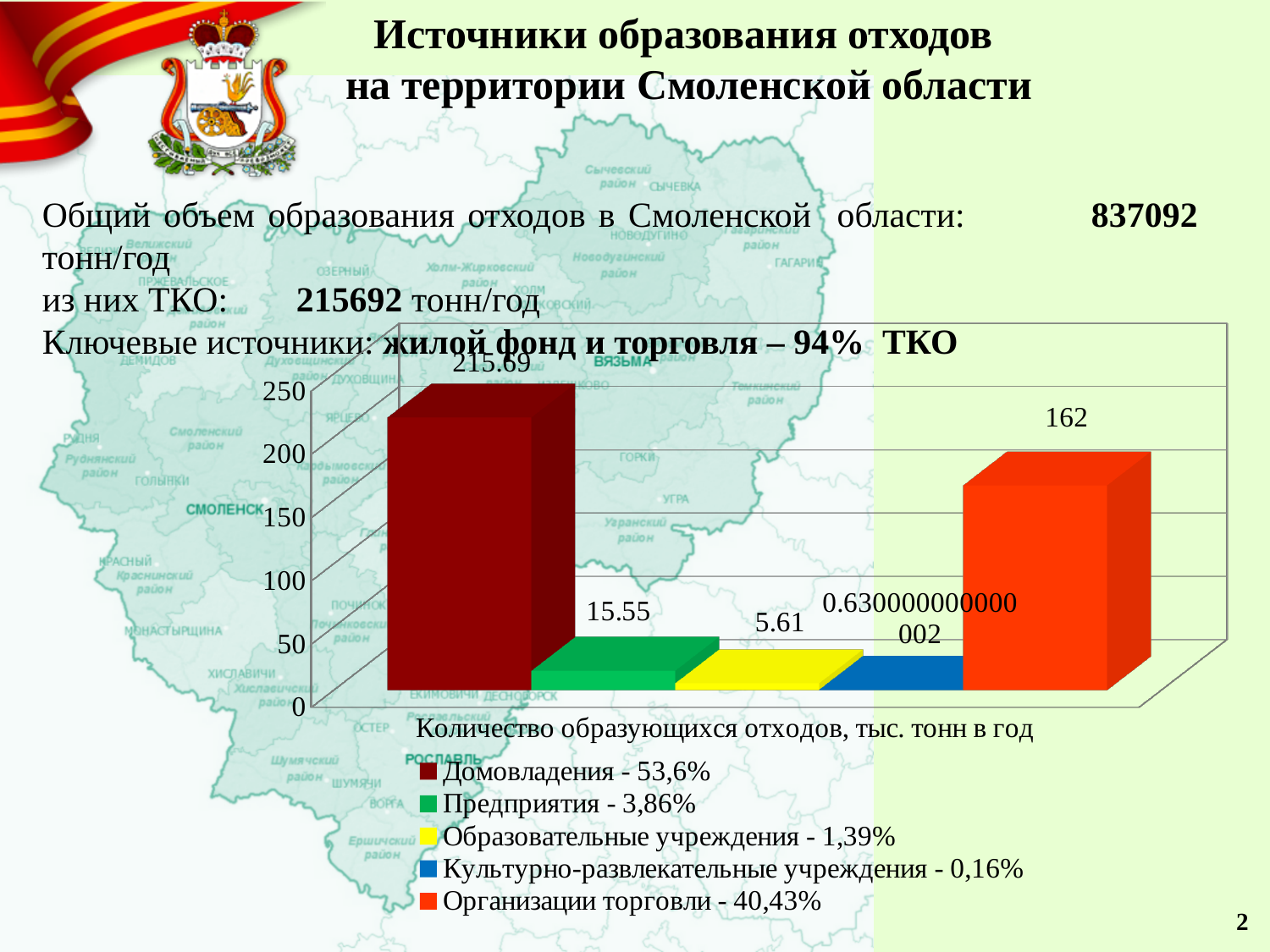
What is the value for Предприятия? 15.55 What is the difference between the values for Домовладения and Организации торговли? 53.69 What is the value for Организации торговли? 162 What percentage share is shown in the legend for Организации торговли? 40,43% Which is larger, the value for Предприятия or the value for Образовательные учреждения? Предприятия How many series does the legend list? 5 Is the value for Организации торговли greater or less than 150? greater What is the value for Образовательные учреждения? 5.61 Which series has the highest value? Домовладения What type of chart is shown on the slide? bar chart What is the value for Домовладения? 215.69 Which series has the lowest value? Культурно-развлекательные учреждения